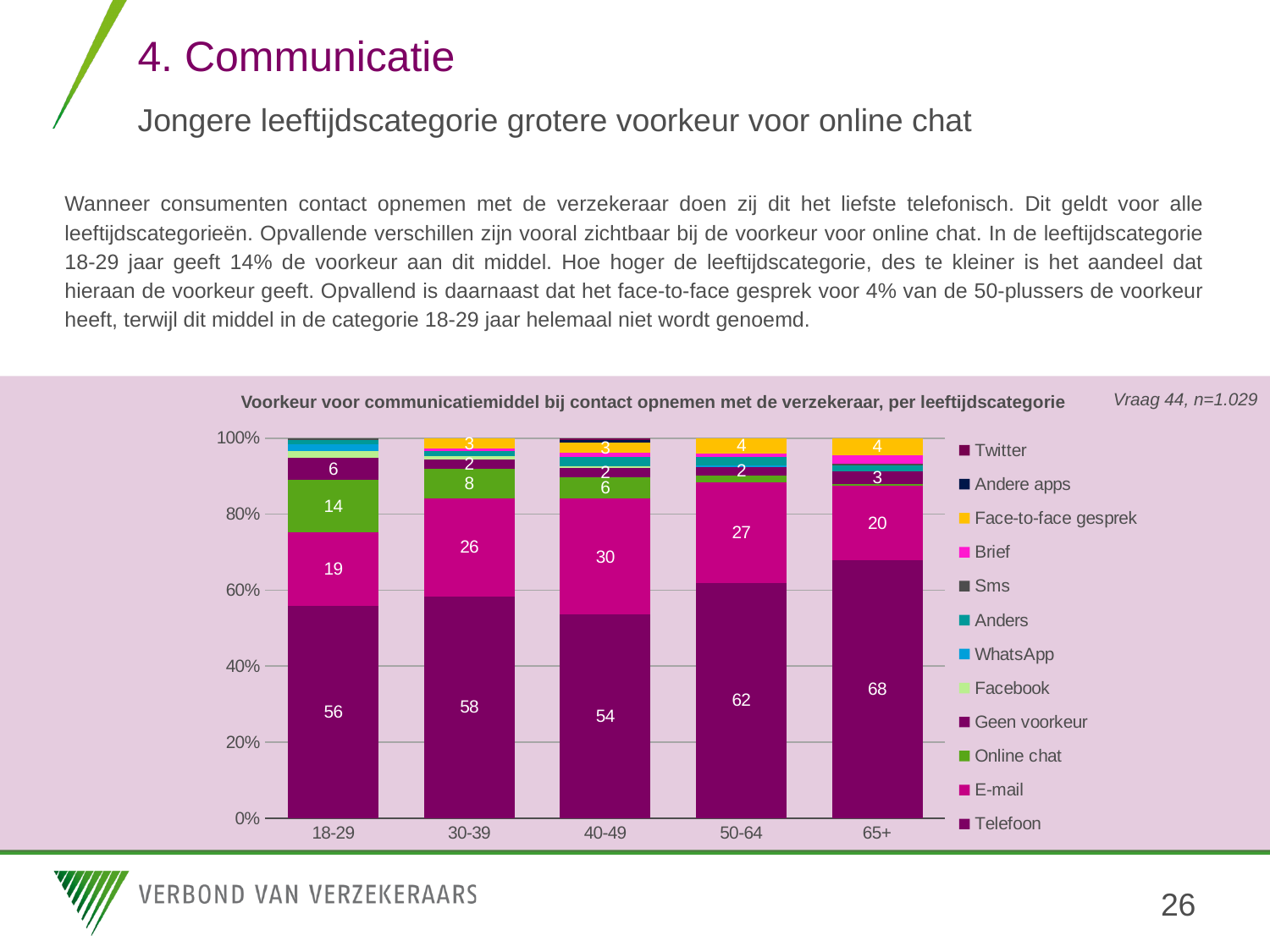
What is the difference between the Telefoon values for 65+ and 40-49? 14 Does the Online chat value rise or fall from 18-29 to 40-49? Fall What is the Online chat value for the 18-29 age group? 14 What kind of chart is shown on the slide? Stacked bar chart What is the Face-to-face gesprek value for the 50-64 age group? 4 What is the Telefoon value for the 65+ age group? 68 How many series does the legend list? 12 Which age group has the highest Telefoon value? 65+ Which age group has the lowest Telefoon value? 40-49 Which age group has the larger E-mail value, 30-39 or 65+? 30-39 What is the E-mail value for the 40-49 age group? 30 How many age groups are shown on the x axis? 5